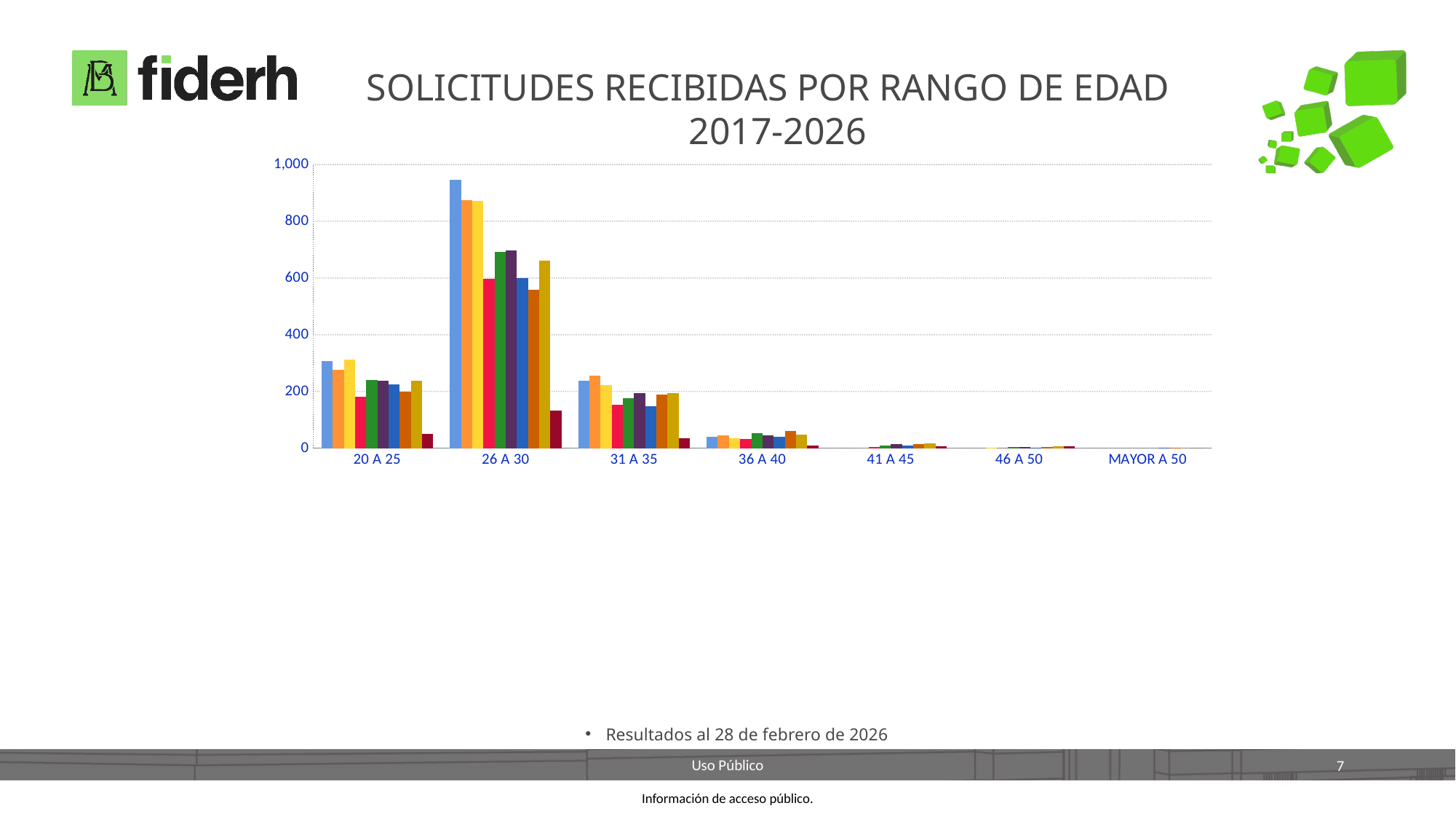
Which age range has the highest bars? 26 A 30 What kind of chart is shown on the slide? Bar chart What is the highest value shown on the y axis? 1,000 Which group has taller bars, 20 A 25 or 36 A 40? 20 A 25 Is the tallest bar in the 20 A 25 group greater or less than 400? less Do the bar heights rise or fall along the x axis from 26 A 30 to MAYOR A 50? fall Which group has taller bars, 26 A 30 or 31 A 35? 26 A 30 How many age-range categories are shown on the x axis? 7 Is the tallest bar in the 26 A 30 group greater or less than 800? greater Which age range has the lowest bars? MAYOR A 50 What is the title of the chart? SOLICITUDES RECIBIDAS POR RANGO DE EDAD 2017-2026 Are the bars in the 36 A 40 group greater or less than 200? less